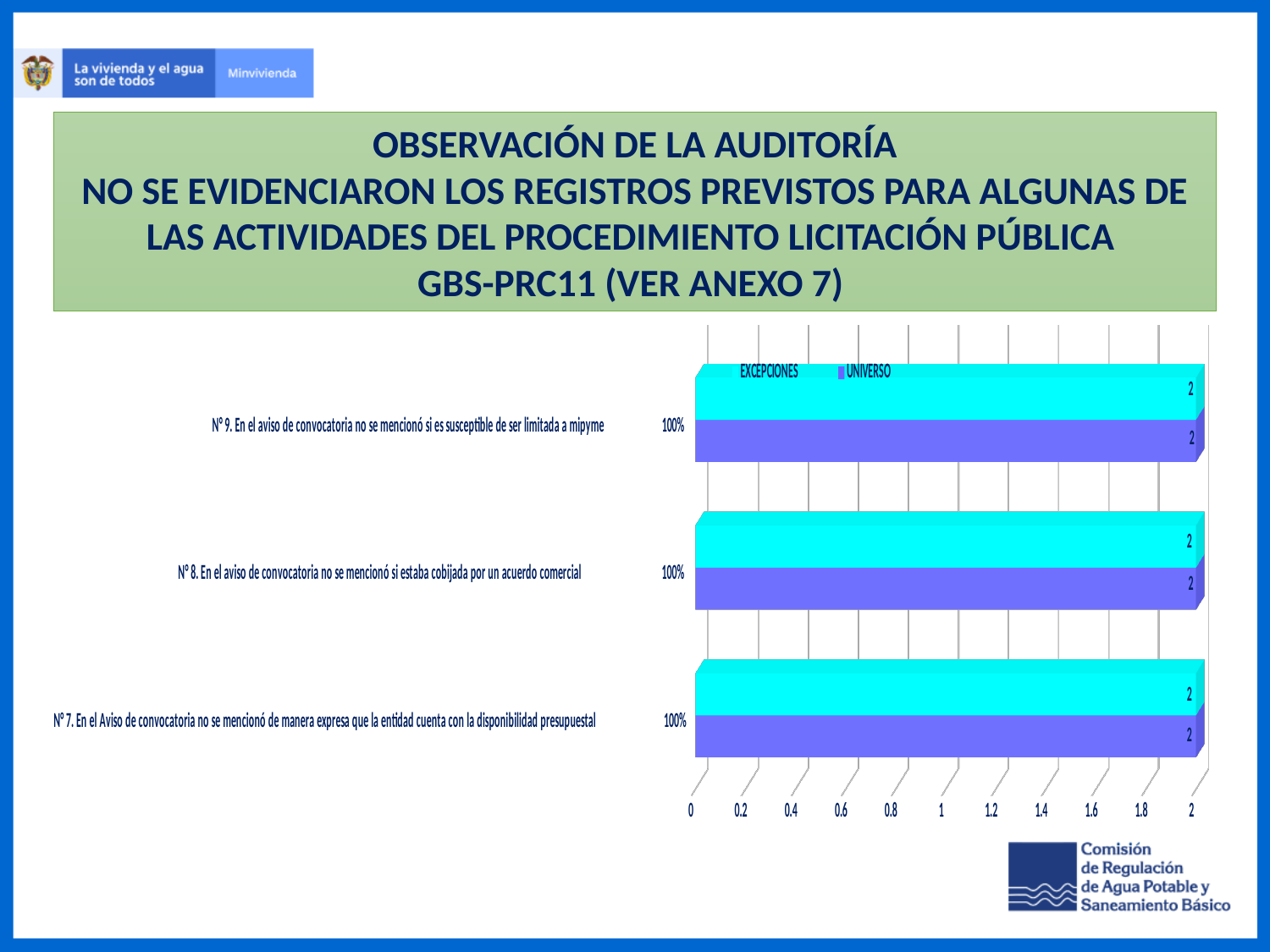
What is the UNIVERSO value for category N° 7? 2 How many categories are plotted in the chart? 3 What is the maximum value shown on the chart's horizontal axis? 2 Is the EXCEPCIONES value for category N° 7 greater or less than 1? greater How many series does the chart legend list? 2 What are the two series names listed in the chart legend? EXCEPCIONES and UNIVERSO What is the EXCEPCIONES value for category N° 8? 2 What is the UNIVERSO value for category N° 9? 2 What kind of chart is shown on the slide? bar chart What is the difference between the EXCEPCIONES and UNIVERSO values for category N° 9? 0 What percentage label is shown next to category N° 8? 100%